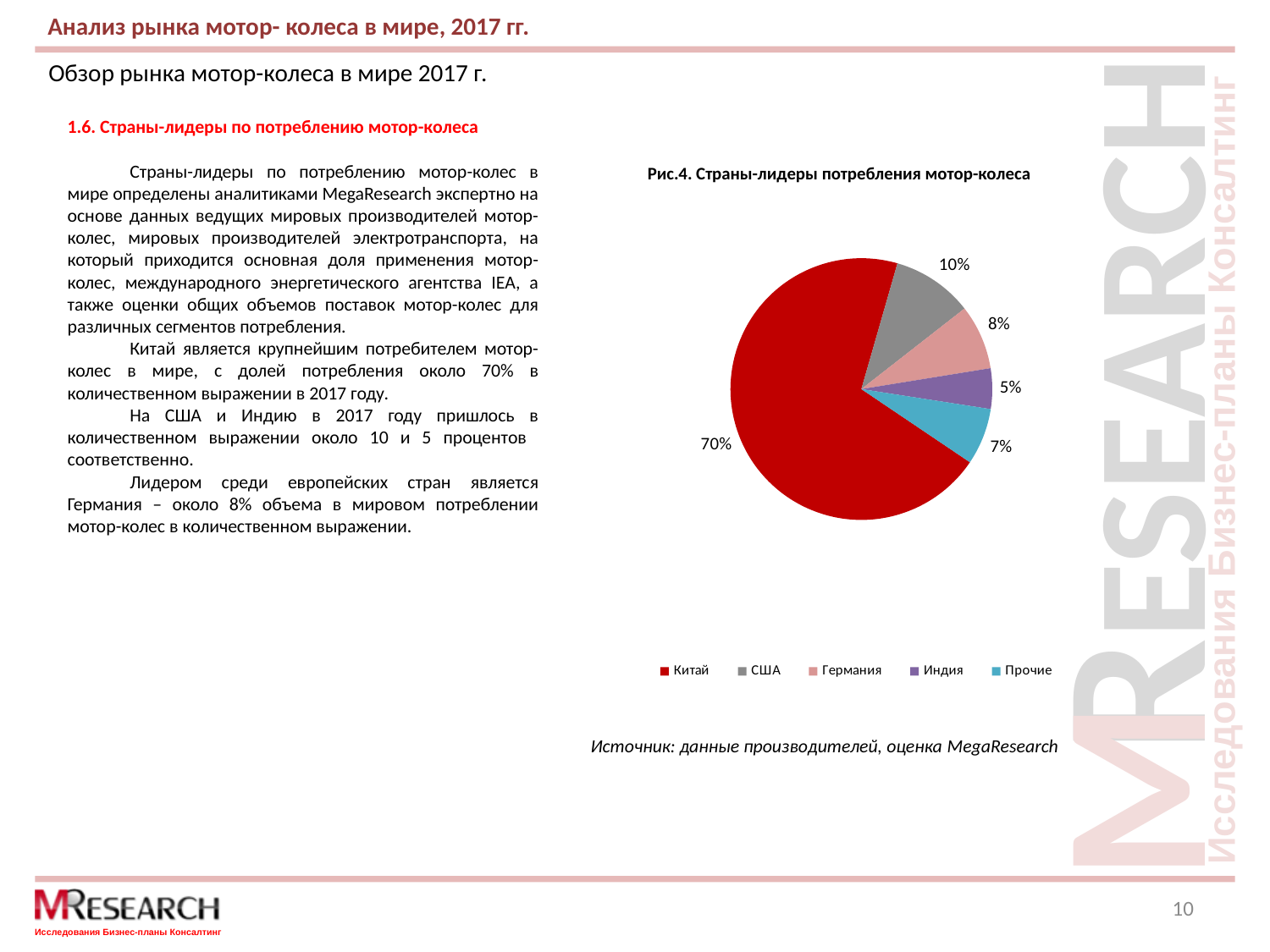
Какая страна имеет наибольшую долю потребления мотор-колеса на диаграмме? Китай Что больше: доля Германии или доля категории «Прочие»? Германия Каким цветом на диаграмме обозначен Китай? Красным Какая категория имеет наименьшую долю на диаграмме? Индия Какая доля приходится на Китай на диаграмме «Рис.4. Страны-лидеры потребления мотор-колеса»? 70% На сколько процентных пунктов доля Китая больше доли США? 60 Какого типа диаграмма на слайде? Круговая диаграмма Какая доля приходится на Германию на диаграмме? 8% Какая доля приходится на Индию на диаграмме? 5% Какая доля приходится на категорию «Прочие» на диаграмме? 7% Какая доля приходится на США на диаграмме? 10% Сколько категорий показано на диаграмме? 5